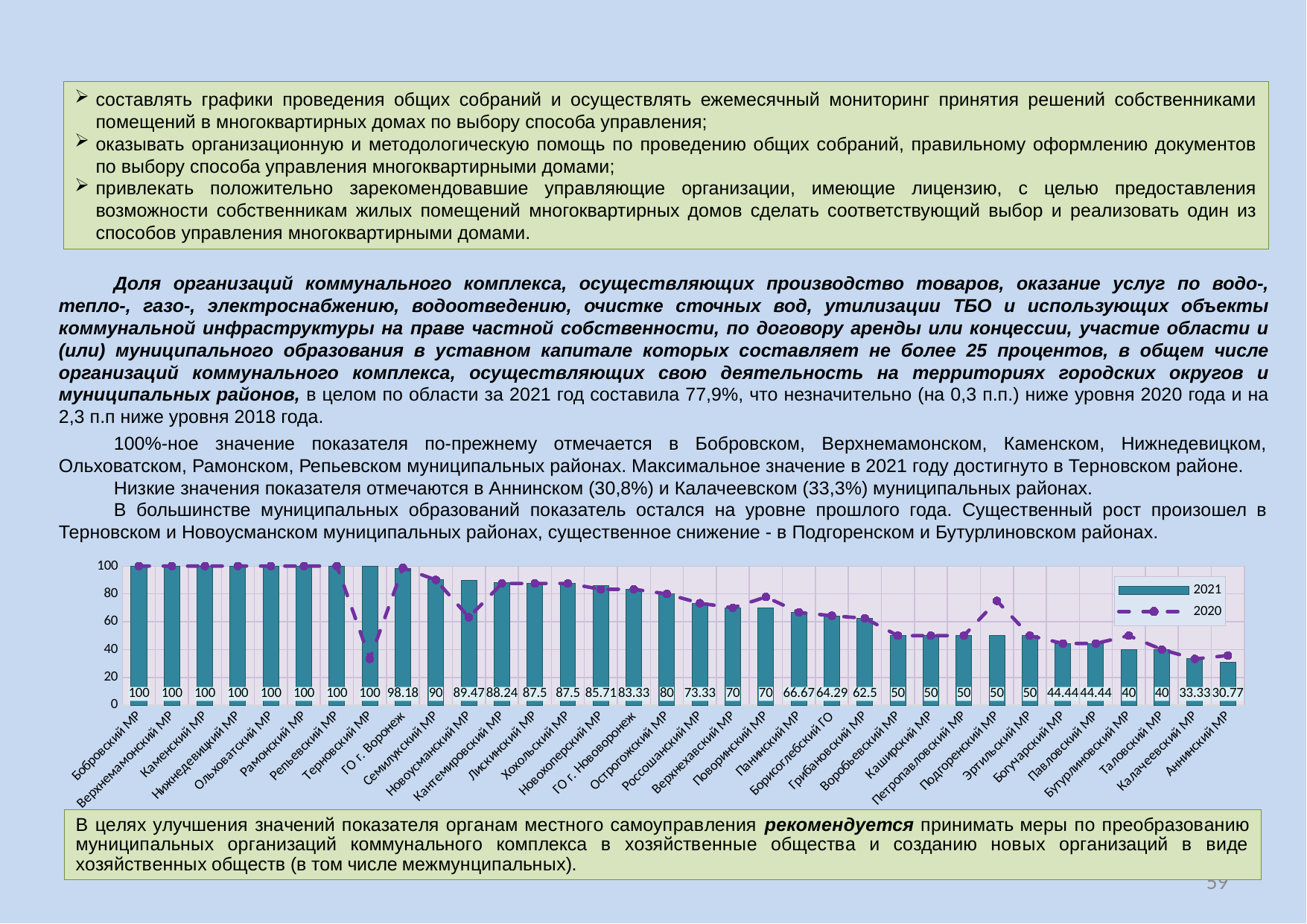
How many series does the legend list? 2 Is the 2020 value for Терновский МР greater or less than 40? less What is the 2021 value for Грибановский МР? 62.5 How many categories are shown on the x axis? 34 What is the difference between the 2021 values for Калачеевский МР and Аннинский МР? 2.56 Do the 2021 values rise or fall from left to right along the x axis? fall Is the 2020 value for Подгоренский МР greater or less than 60? greater Which category has the lowest 2021 value? Аннинский МР What is the 2021 value for Аннинский МР? 30.77 What is the difference between the 2021 values for Острогожский МР and Россошанский МР? 6.67 What is the 2021 value for ГО г. Воронеж? 98.18 Which has the larger 2021 value, Семилукский МР or Новоусманский МР? Семилукский МР